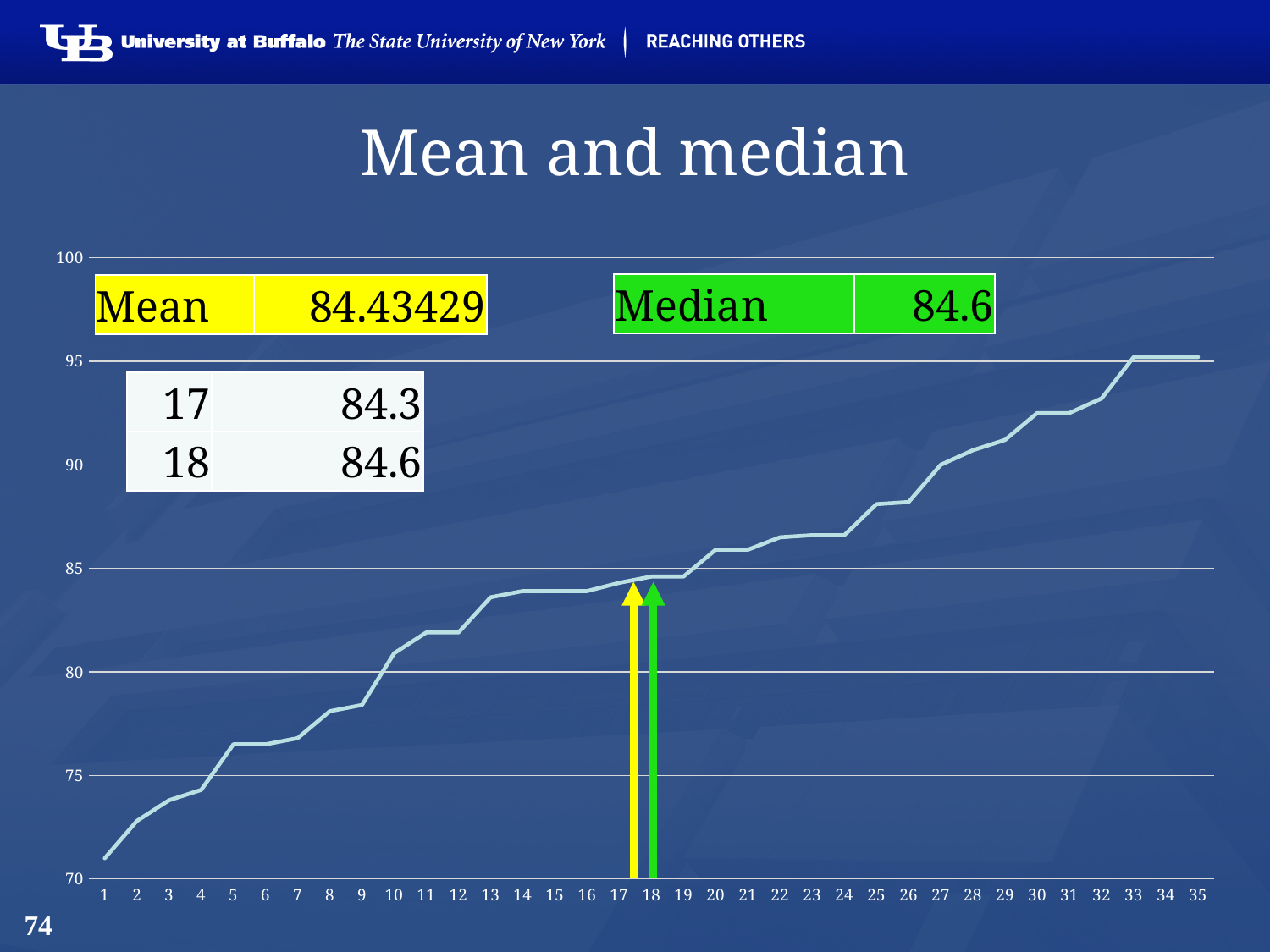
What is the mean value shown on the slide? 84.43429 Is the value for point 30 greater or less than 90? greater What is the value for point 17 according to the table on the slide? 84.3 What is the title of the slide? Mean and median What is the value for point 18 according to the table on the slide? 84.6 Is the value for point 1 greater or less than 75? less What is the median value shown on the slide? 84.6 Which point has the lowest value on the chart? 1 What kind of chart is shown on the slide? line chart How many data points are plotted along the x axis? 35 Do the plotted values rise or fall as the x axis goes from 1 to 35? rise What is the difference between the values for point 18 and point 17? 0.3